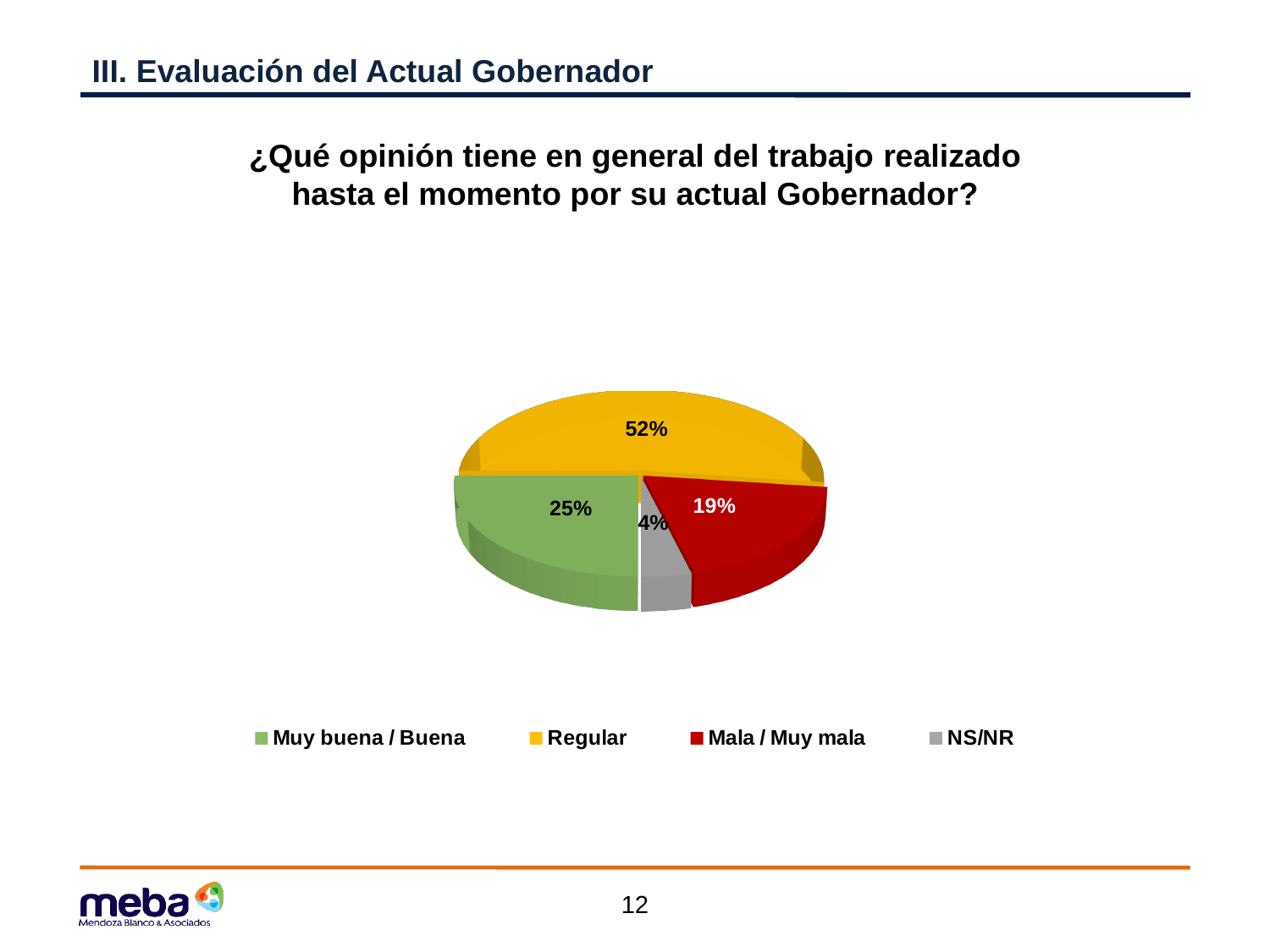
What is the difference in percentage points between "Mala / Muy mala" and "NS/NR"? 15 How many categories does the pie chart show? 4 What percentage of respondents answered "Mala / Muy mala"? 19% Which category has the largest share of the pie? Regular What kind of chart is shown on the slide? Pie chart What percentage of respondents answered "Regular"? 52% What colour represents the "Mala / Muy mala" category? Red What percentage of respondents answered "Muy buena / Buena"? 25% What percentage of respondents answered "NS/NR"? 4% Which is larger, the share for "Muy buena / Buena" or the share for "Mala / Muy mala"? Muy buena / Buena Which category has the smallest share of the pie? NS/NR What is the difference in percentage points between "Regular" and "Muy buena / Buena"? 27